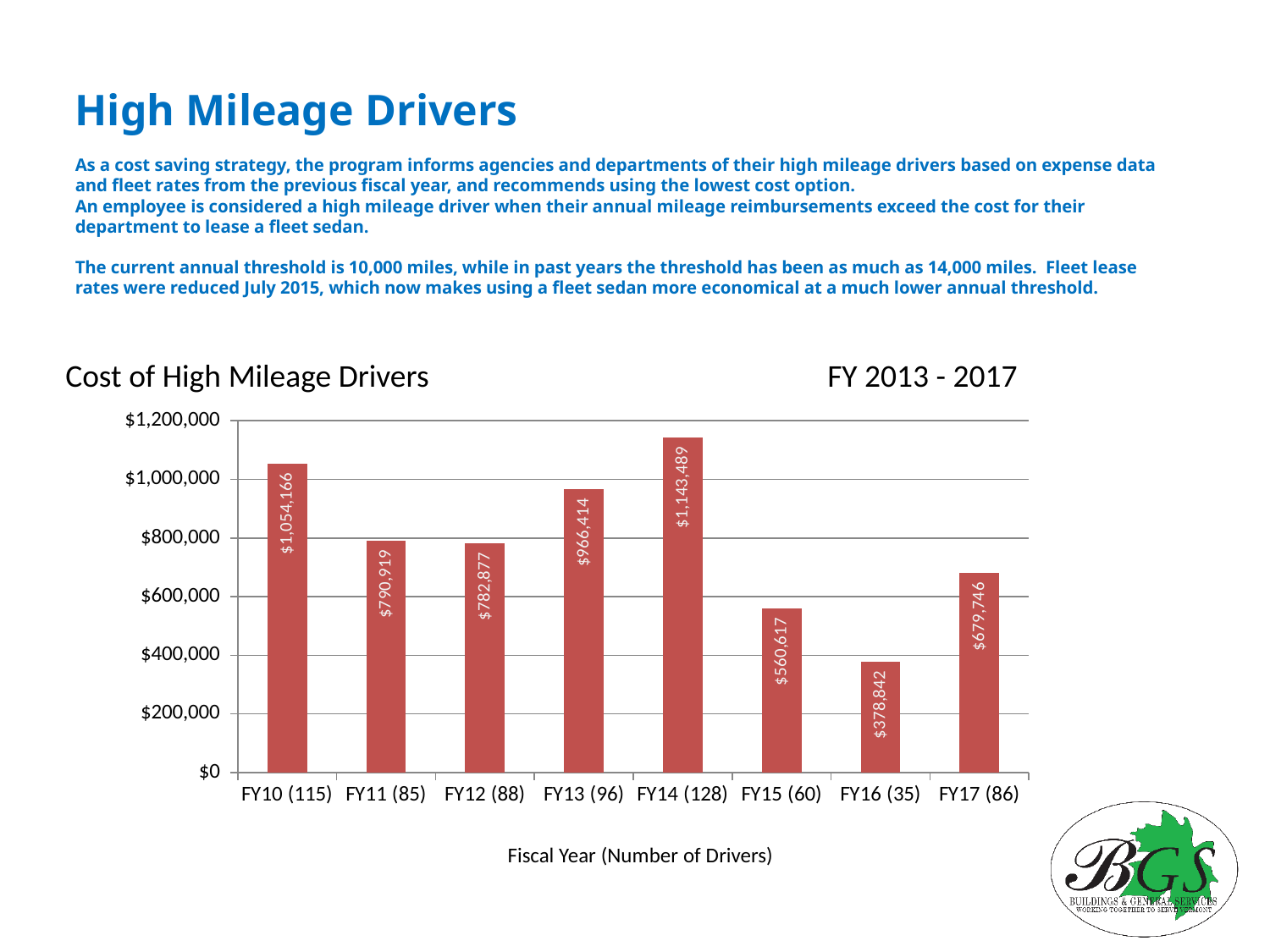
What is the cost of high mileage drivers for FY16 (35)? $378,842 What kind of chart is used to show the cost of high mileage drivers? bar chart What is the difference between the cost for FY10 (115) and the cost for FY11 (85)? $263,247 What is the cost of high mileage drivers for FY14 (128)? $1,143,489 Which fiscal year has the lowest cost of high mileage drivers? FY16 (35) Is the cost for FY15 (60) greater or less than $600,000? less Do the costs rise or fall from FY14 (128) to FY16 (35)? fall Which fiscal year has the highest cost of high mileage drivers? FY14 (128) What is the difference between the cost for FY14 (128) and the cost for FY16 (35)? $764,647 What is the cost of high mileage drivers for FY17 (86)? $679,746 Which has a higher cost of high mileage drivers, FY13 (96) or FY17 (86)? FY13 (96) How many fiscal years are shown in the chart? 8